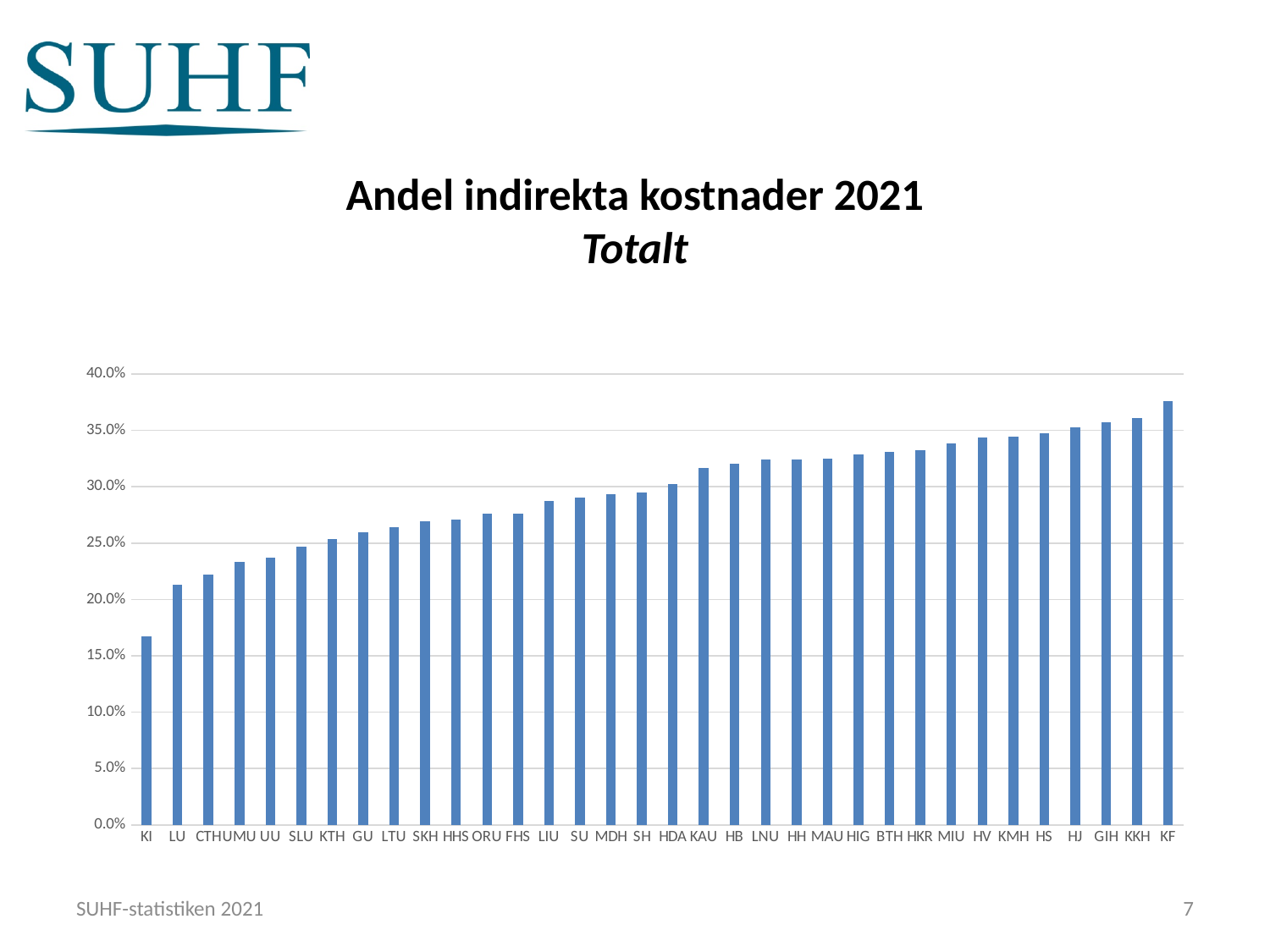
Which category has the lowest value in the chart? KI Is the value for GU greater or less than 30.0%? less What is the title of the chart? Andel indirekta kostnader 2021 Totalt How many categories (bars) are shown in the chart? 34 What kind of chart is shown on the slide? bar chart Is the value for LU greater or less than 20.0%? greater Which is larger, the value for UU or the value for HB? HB Is the value for KF greater or less than 35.0%? greater Which is larger, the value for KTH or the value for HJ? HJ Do the values rise or fall from left to right along the x axis? rise Which category has the highest value in the chart? KF